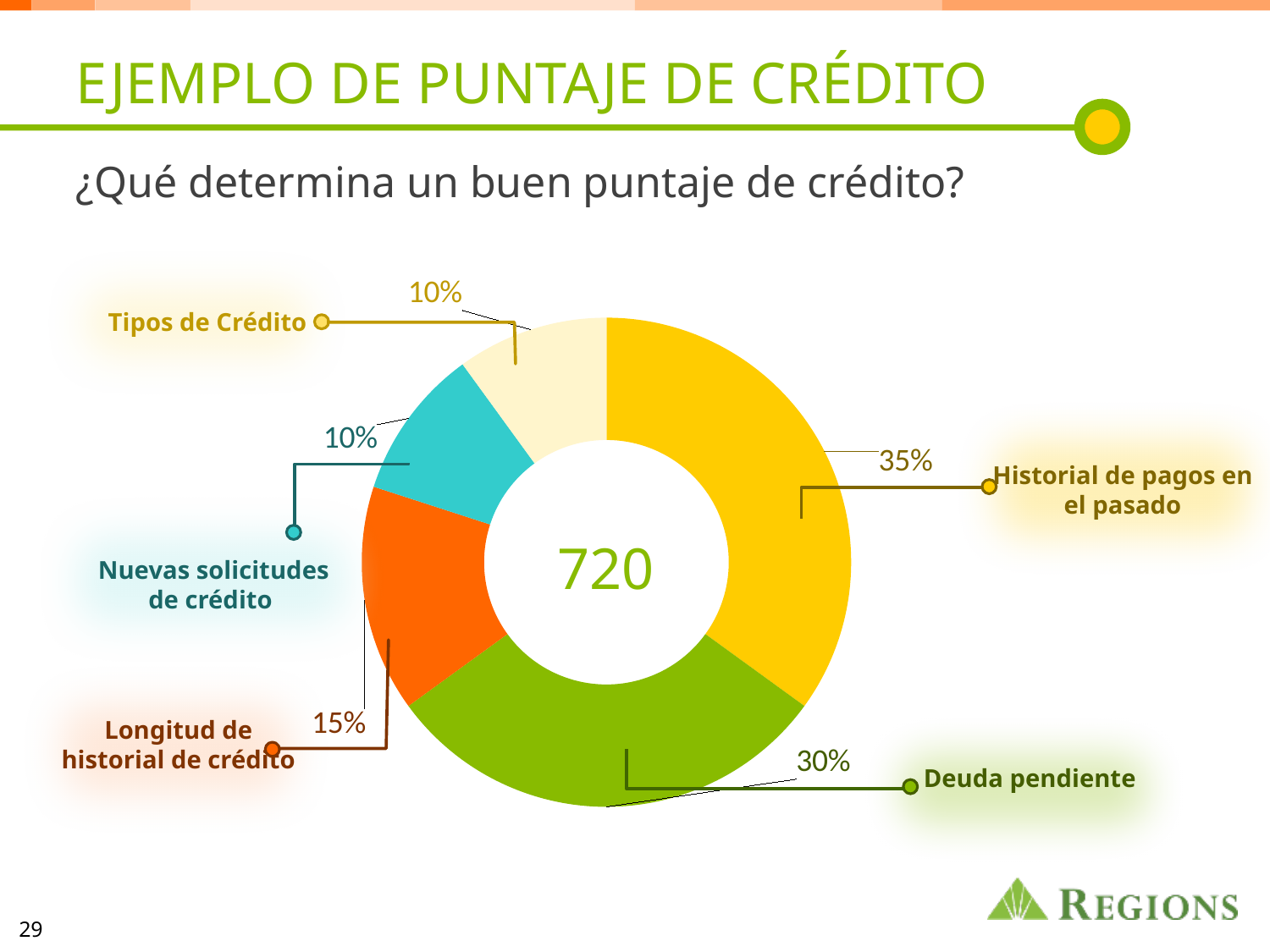
What number is displayed in the center of the doughnut chart? 720 What percentage does the chart show for Historial de pagos en el pasado? 35% Which category has the largest share of the chart? Historial de pagos en el pasado What percentage does the chart show for Nuevas solicitudes de crédito? 10% Which category is shown in the green slice of the chart? Deuda pendiente What percentage does the chart show for Longitud de historial de crédito? 15% Which is larger, the share for Deuda pendiente or the share for Longitud de historial de crédito? Deuda pendiente What is the difference in percentage points between Historial de pagos en el pasado and Deuda pendiente? 5 What kind of chart is shown on the slide? Doughnut chart What percentage does the chart show for Deuda pendiente? 30% What is the combined share of Nuevas solicitudes de crédito and Tipos de Crédito? 20% How many categories are shown in the chart? 5